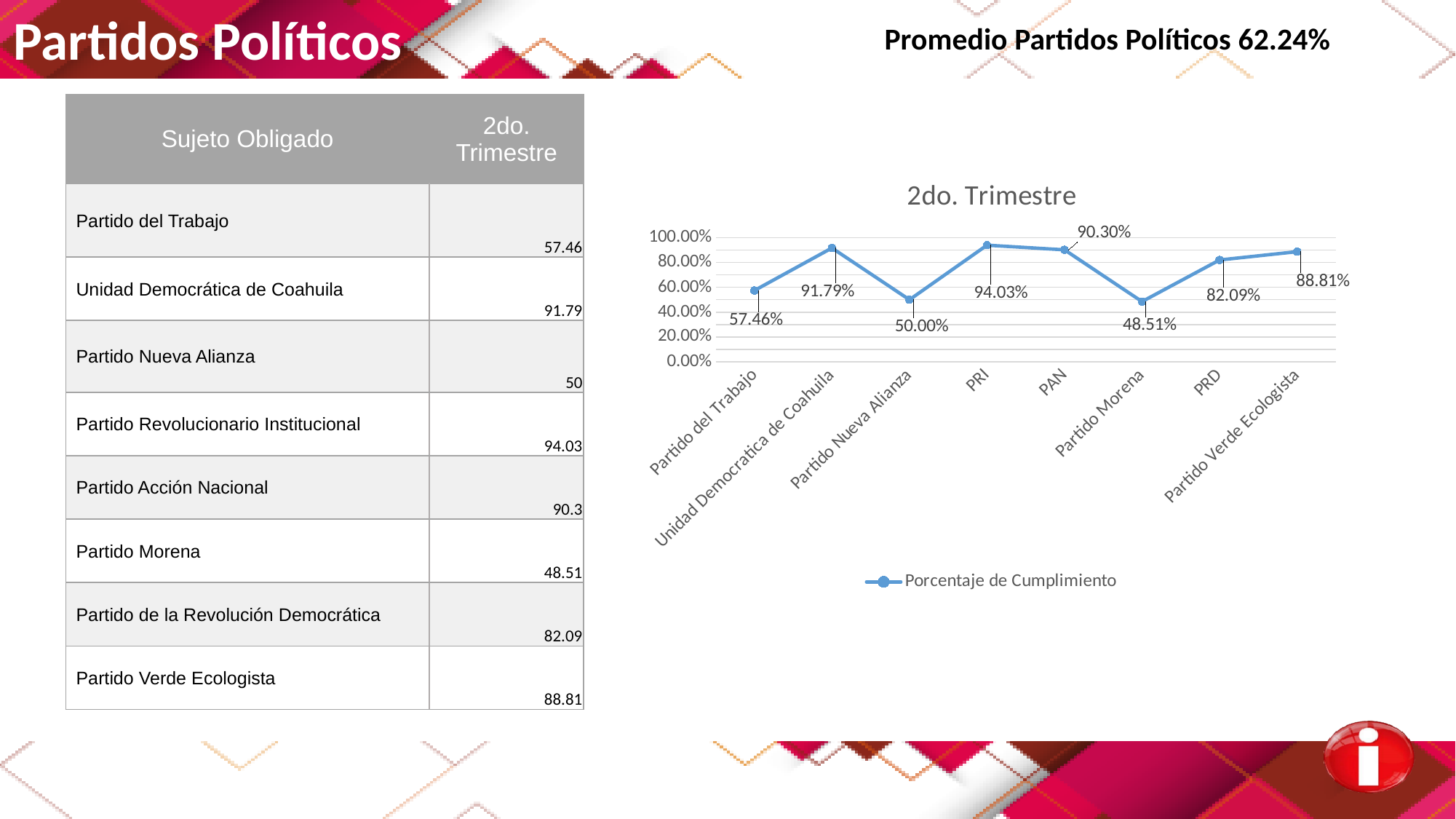
What is the value for Partido Morena in the chart? 48.51% What is the difference between the values for PAN and PRD? 8.21% How many series does the chart legend list? 1 Which category has the highest value in the chart? PRI Is the value for Partido del Trabajo greater or less than 80.00%? less Which category has the lowest value in the chart? Partido Morena What is the title of the chart? 2do. Trimestre What is the value for PRI in the chart? 94.03% How many categories are plotted in the chart? 8 What kind of chart is shown on the slide? line chart What is the value for Partido Verde Ecologista in the chart? 88.81% Which is larger, the value for Unidad Democratica de Coahuila or the value for Partido Verde Ecologista? Unidad Democratica de Coahuila